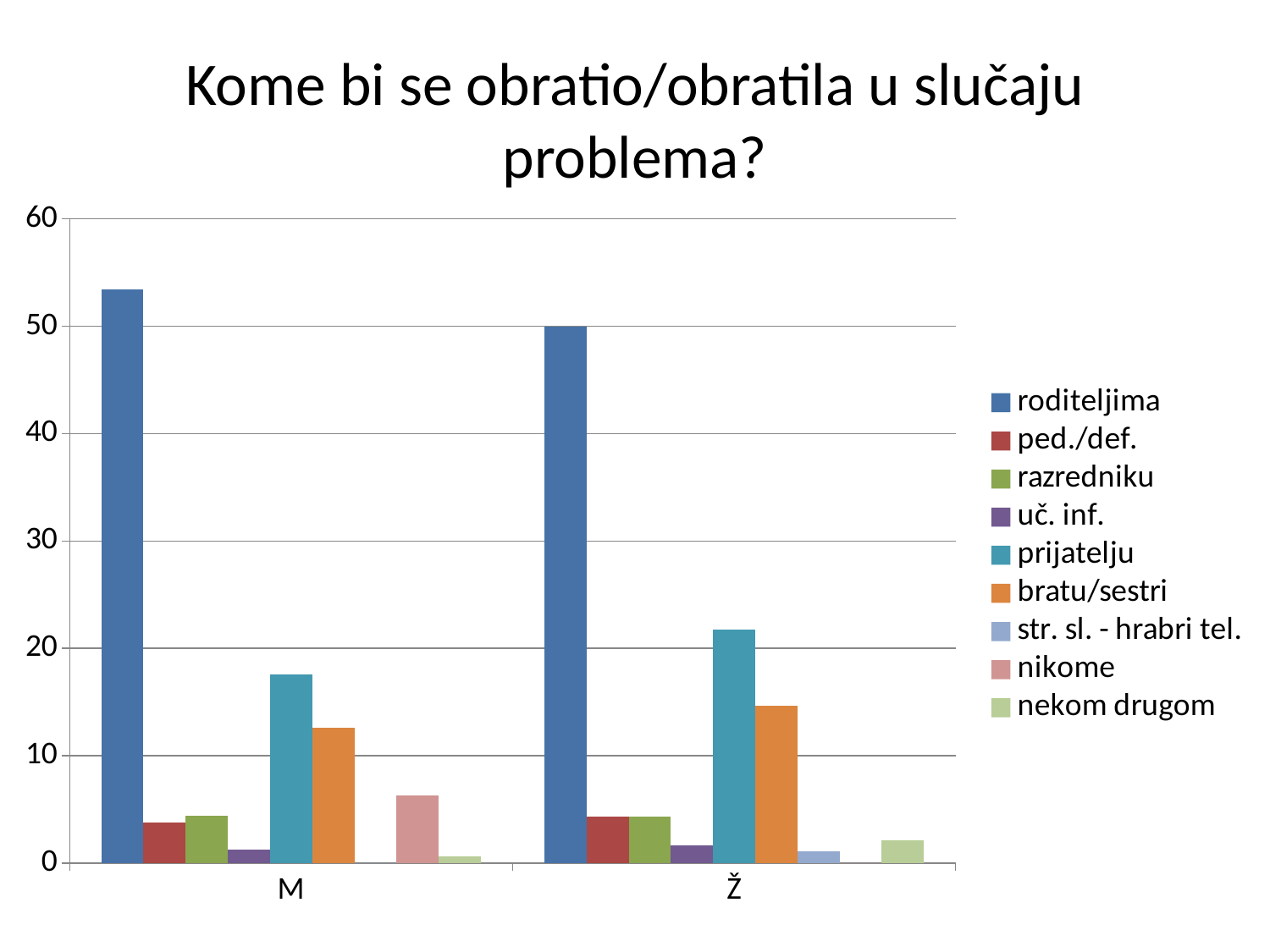
Is the value for bratu/sestri in the M category greater or less than 10? greater What is the title of the chart? Kome bi se obratio/obratila u slučaju problema? Is the value for prijatelju in the M category greater or less than 20? less How many series does the legend list? 9 Which category has the larger value for roditeljima, M or Ž? M Which series has the highest value for the M category? roditeljima Which series has the highest value for the Ž category? roditeljima Which category has the larger value for prijatelju, M or Ž? Ž What kind of chart is shown on the slide? bar chart Is the value for prijatelju in the Ž category greater or less than 20? greater How many categories are shown on the x axis? 2